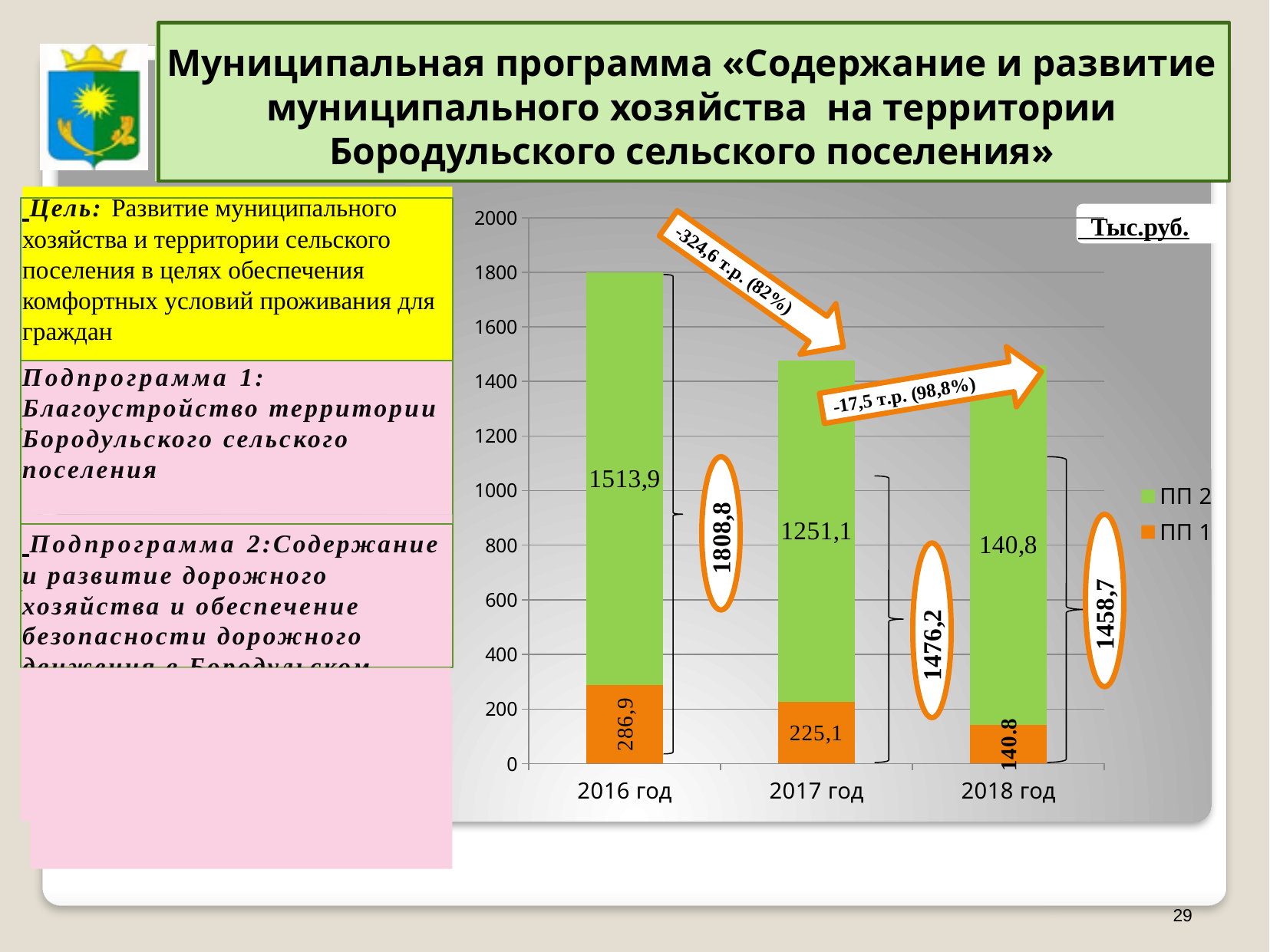
Do the ПП 1 values rise or fall from 2016 год to 2018 год? fall What is the value of ПП 1 for 2018 год? 140.8 What is the value of ПП 2 for 2017 год? 1251,1 In which year is the ПП 1 value the highest? 2016 год What is the difference between the ПП 1 values for 2016 год and 2017 год? 61,8 Which year has the higher ПП 2 value, 2016 год or 2017 год? 2016 год What is the value of ПП 2 for 2016 год? 1513,9 What kind of chart is shown on the slide? stacked bar chart How many series does the legend list? 2 What is the total of the stacked bar for 2017 год? 1476,2 What is the value of ПП 1 for 2016 год? 286,9 How many years (categories) are shown on the x axis? 3